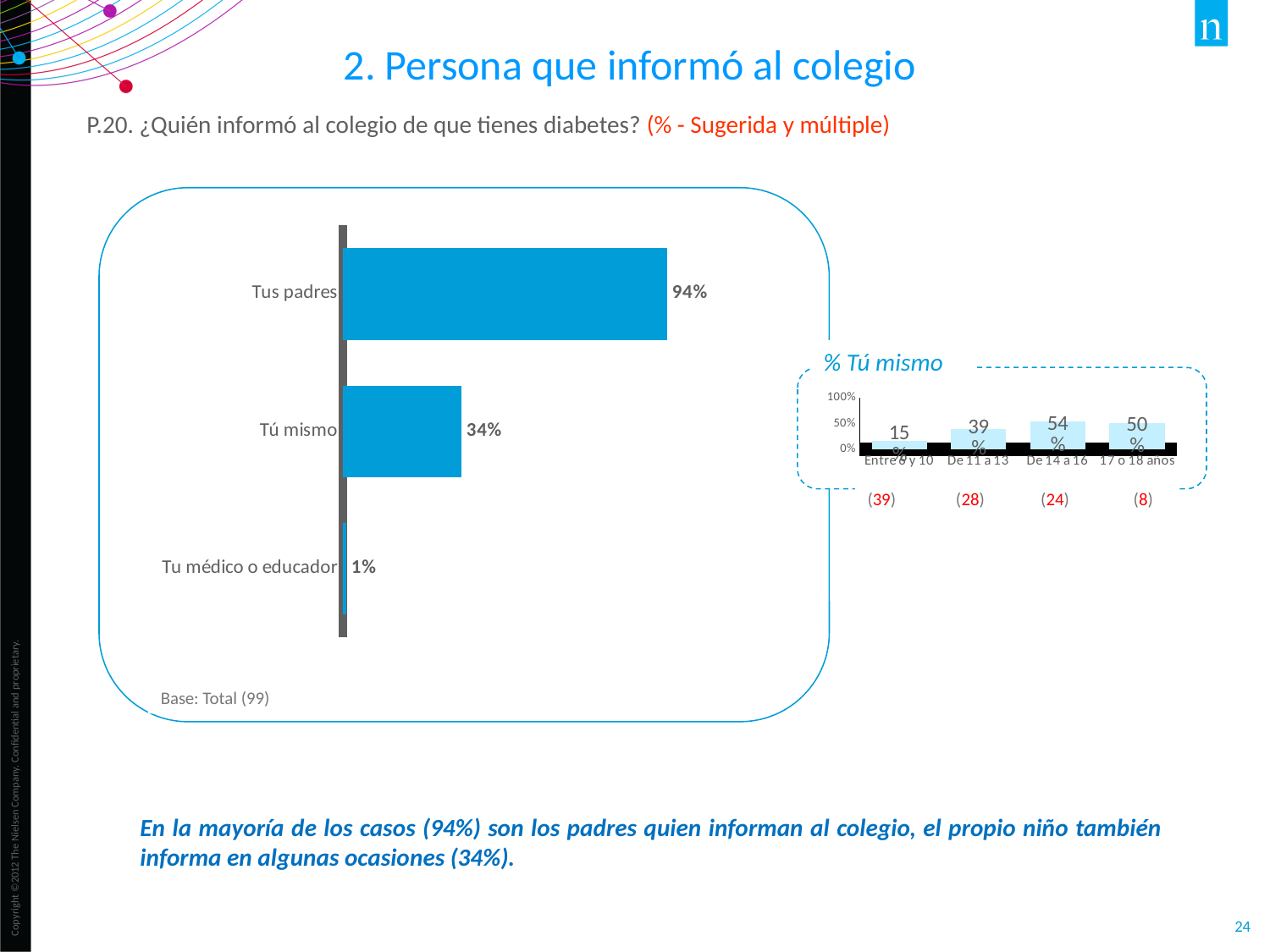
What kind of chart is the main chart on the left? Bar chart In the main bar chart on the left, what is the value for 'Tu médico o educador'? 1% In the main bar chart on the left, which category has the lowest value? Tu médico o educador In the '% Tú mismo' chart on the right, is the value for 'De 14 a 16' larger or smaller than the value for '17 o 18 años'? Larger In the main bar chart on the left, what is the value for 'Tus padres'? 94% In the '% Tú mismo' chart on the right, which age group has the lowest value? Entre 6 y 10 In the main bar chart on the left, how many categories are shown? 3 In the '% Tú mismo' chart on the right, what is the value for 'De 11 a 13'? 39% In the main bar chart on the left, what is the difference between the values for 'Tus padres' and 'Tú mismo'? 60 percentage points In the '% Tú mismo' chart on the right, what is the value for 'De 14 a 16'? 54% In the main bar chart on the left, which category has the highest value? Tus padres In the main bar chart on the left, what is the value for 'Tú mismo'? 34%